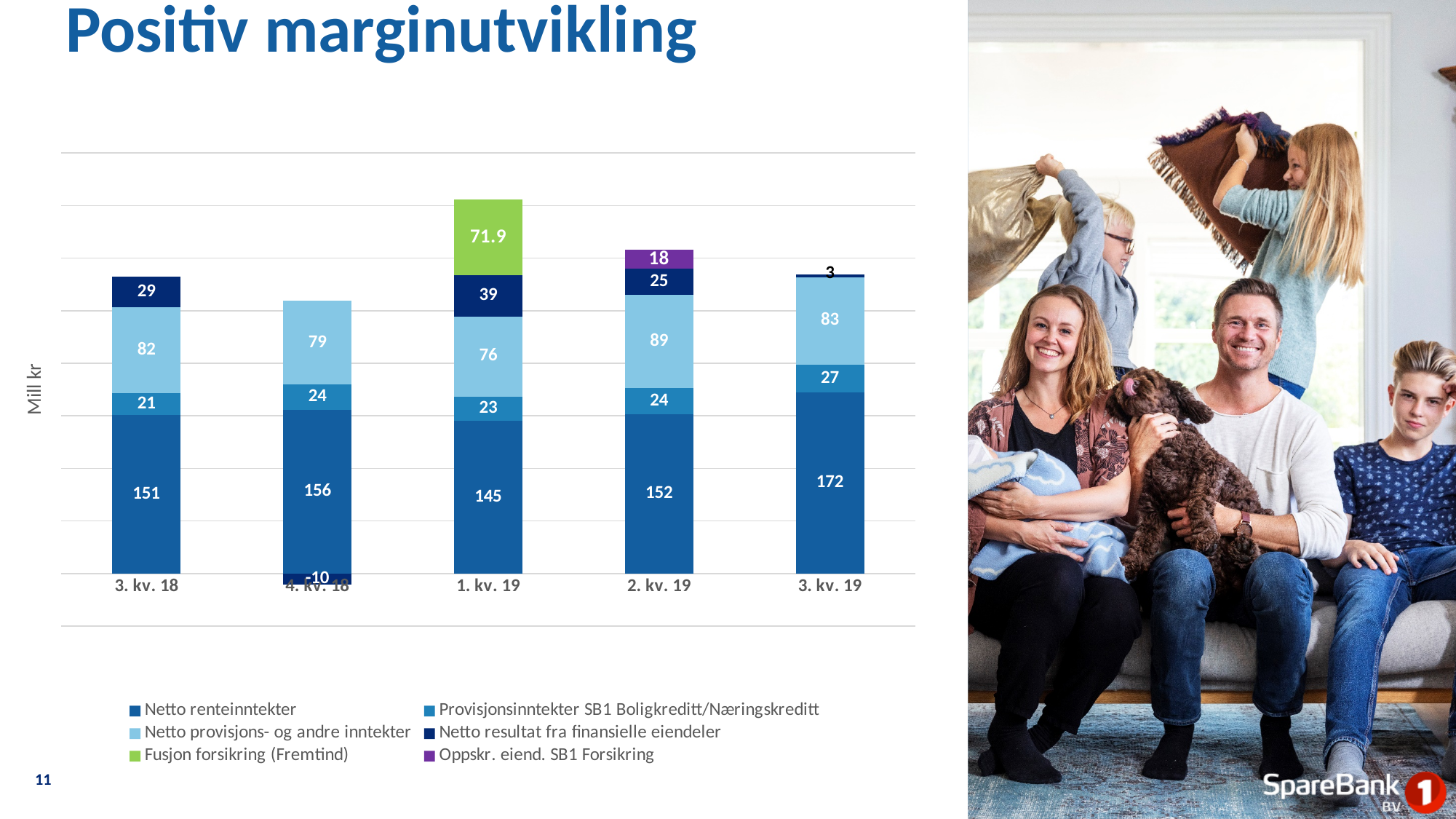
What is the value of Netto resultat fra finansielle eiendeler for 4. kv. 18? -10 In which quarter is Netto renteinntekter highest? 3. kv. 19 What is the value of Fusjon forsikring (Fremtind) for 1. kv. 19? 71.9 What is the value of Netto renteinntekter for 3. kv. 19? 172 How many series does the legend list? 6 How many quarters are shown on the x axis? 5 Which is larger: Netto provisjons- og andre inntekter in 2. kv. 19 or in 1. kv. 19? 2. kv. 19 What kind of chart is shown on the slide? Stacked bar chart What is the difference in Netto renteinntekter between 3. kv. 19 and 3. kv. 18? 21 What is the value of Netto provisjons- og andre inntekter for 2. kv. 19? 89 In which quarter is Netto renteinntekter lowest? 1. kv. 19 What is the total of the stacked bar for 2. kv. 19? 308